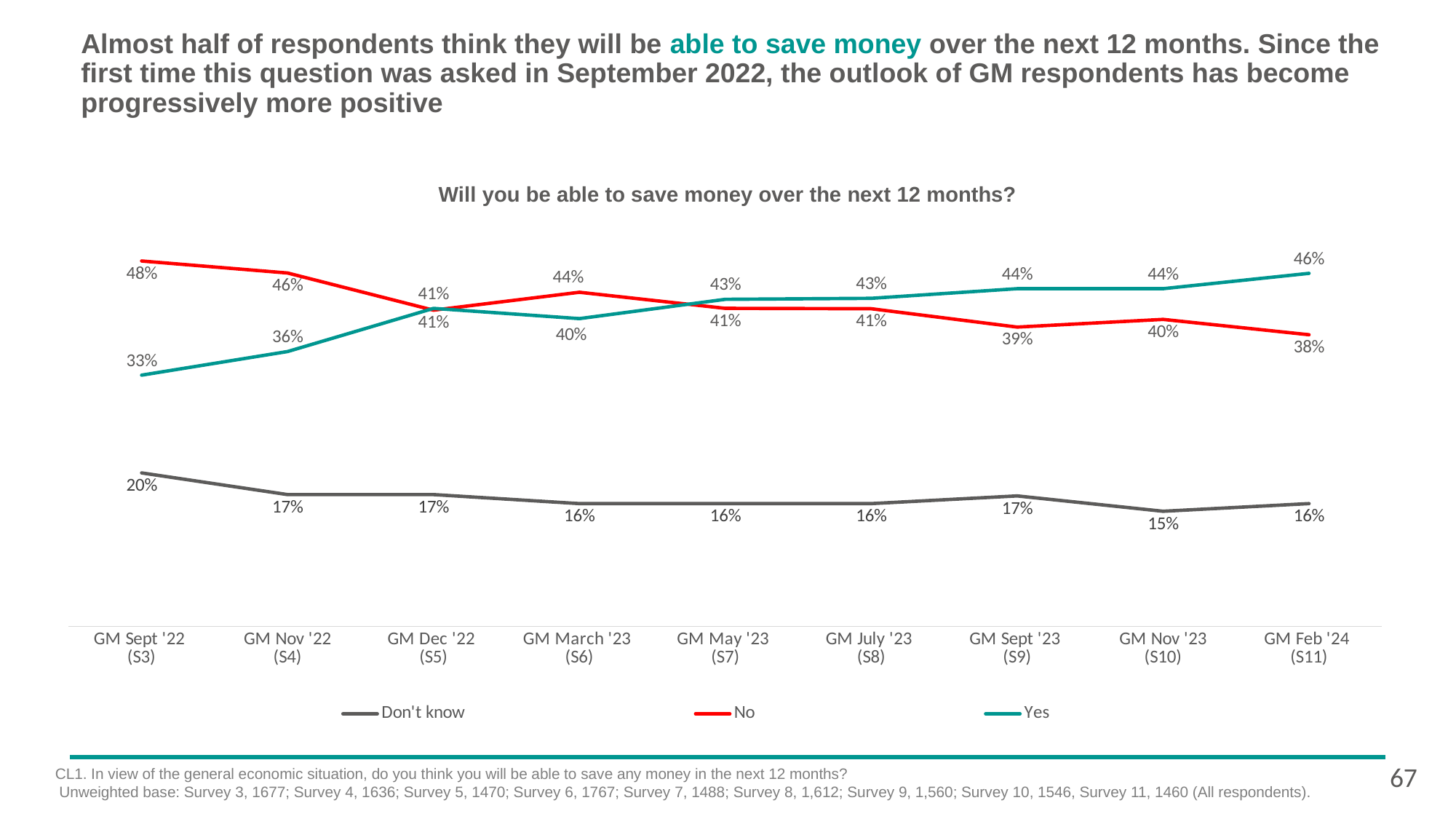
How many survey points are shown on the x axis? 9 At which survey point is the Yes series at its lowest? GM Sept '22 (S3) At which survey point is the No series at its highest? GM Sept '22 (S3) Does the Yes series generally rise or fall from GM Sept '22 to GM Feb '24? Rise What is the value for Don't know at GM Nov '23 (S10)? 15% What kind of chart is shown on the slide? Line chart What colour is the line for the No series? Red What is the difference between the Yes and No values at GM Feb '24 (S11)? 8 percentage points What is the value for No at GM Sept '22 (S3)? 48% What is the value for Yes at GM Feb '24 (S11)? 46% At GM March '23 (S6), which is larger, Yes or No? No How many series does the legend list? 3